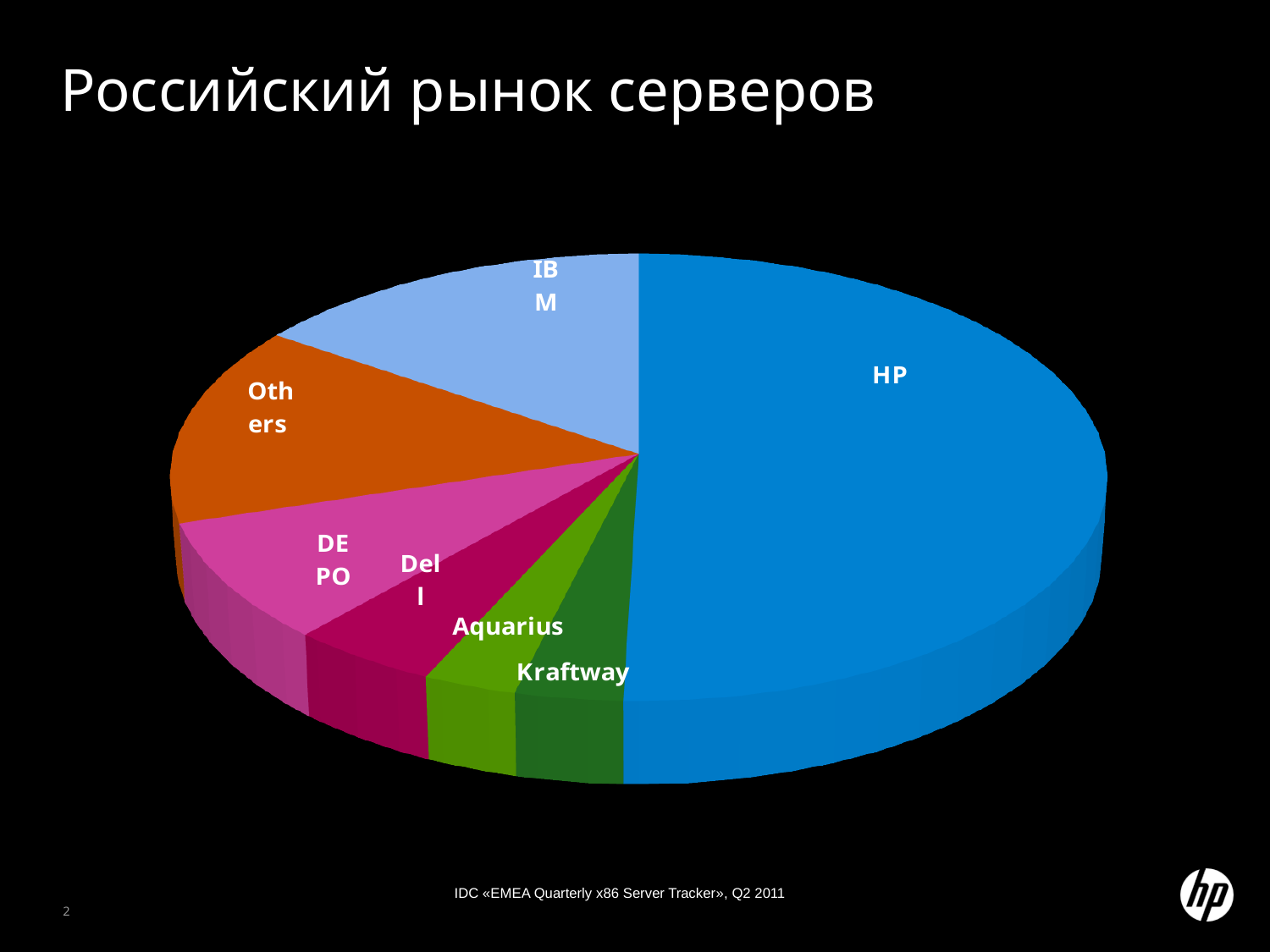
What is the title of the slide? Российский рынок серверов What colour is the HP slice? blue What kind of chart is shown on the slide? pie chart Which vendor has the largest slice of the pie chart? HP Which slice is larger, Others or DEPO? Others Which slice is larger, IBM or Aquarius? IBM Which slice is larger, DEPO or Kraftway? DEPO How many slices does the pie chart have? 7